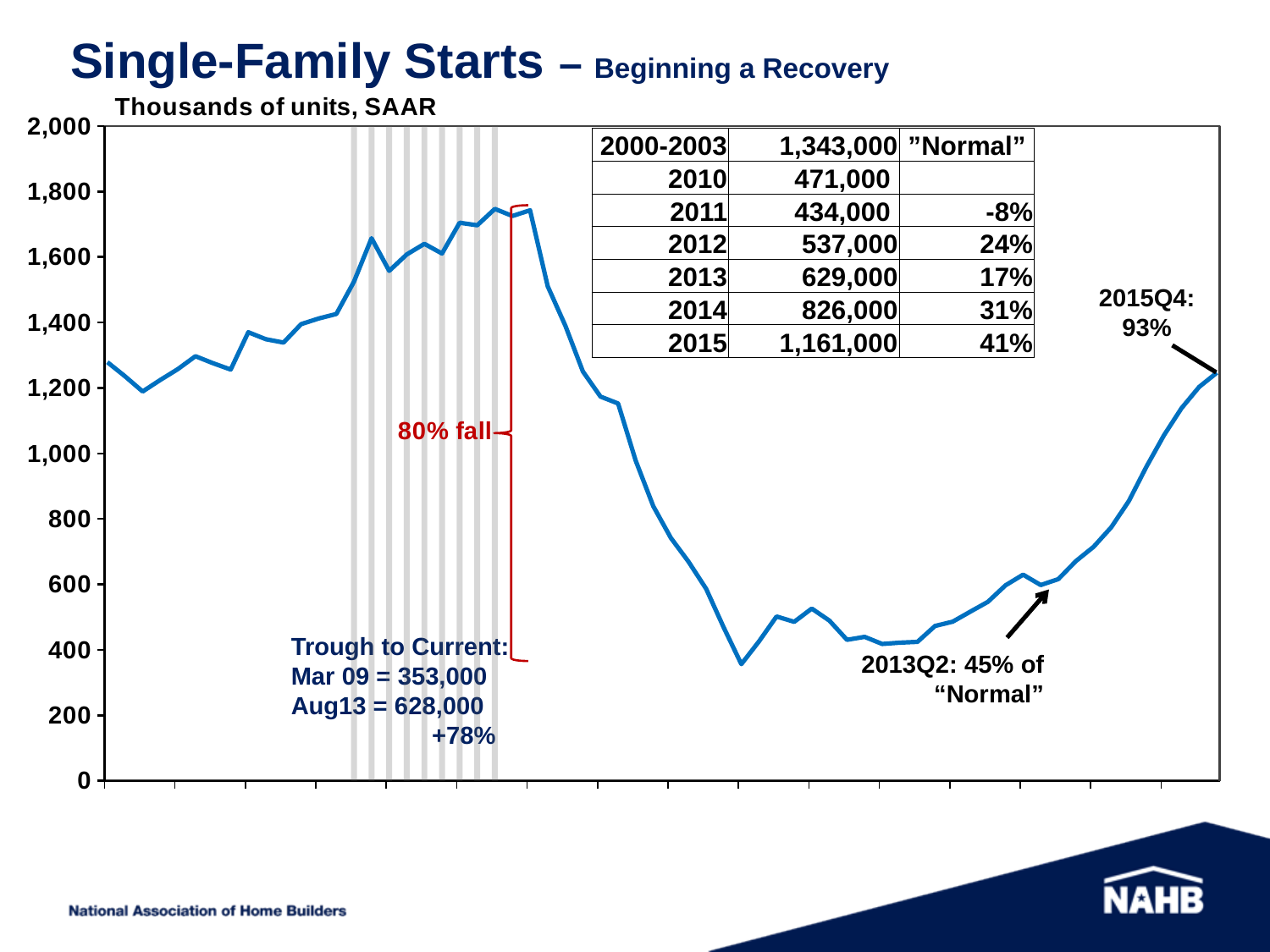
In the table on the chart, what is the percentage change shown for 2015? 41% What percentage does the annotation give for 2015Q4? 93% What is the title of the chart on the slide? Single-Family Starts – Beginning a Recovery Using the table values, what is the difference between the 2015 value and the 2014 value? 335,000 What units does the chart's y axis use, according to the label above it? Thousands of units, SAAR What percentage fall from the peak does the red annotation indicate? 80% fall According to the annotation, what was the value of single-family starts in Aug13? 628,000 According to the annotation, what was the value of single-family starts at the trough in Mar 09? 353,000 What kind of chart is shown on the slide? line chart In the table on the chart, what is the value for 2014? 826,000 What percentage change from trough to current does the annotation give? +78% What percentage of "Normal" does the annotation give for 2013Q2? 45%